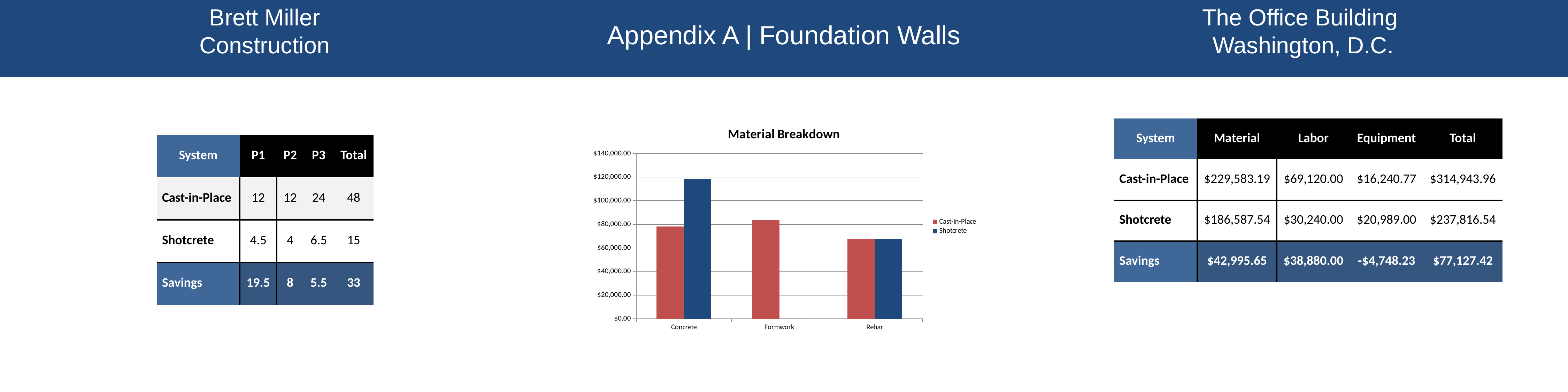
In the Material Breakdown chart, is the Cast-in-Place value for Rebar greater or less than $80,000.00? less In the Material Breakdown chart, is the Cast-in-Place value for Concrete greater or less than $100,000.00? less How many series does the legend of the Material Breakdown chart list? 2 In the Material Breakdown chart, which category has no Shotcrete bar? Formwork In the Material Breakdown chart, which category has the lowest Cast-in-Place bar? Rebar What kind of chart is the Material Breakdown chart? bar chart What is the title of the chart on the slide? Material Breakdown How many categories are shown on the x axis of the Material Breakdown chart? 3 In the Material Breakdown chart, which series has the tallest bar for Concrete? Shotcrete In the Material Breakdown chart, which category has the tallest bar overall? Concrete In the Material Breakdown chart, is the Shotcrete value for Concrete greater or less than $100,000.00? greater In the Material Breakdown chart, for Concrete, is the Shotcrete bar larger or smaller than the Cast-in-Place bar? larger